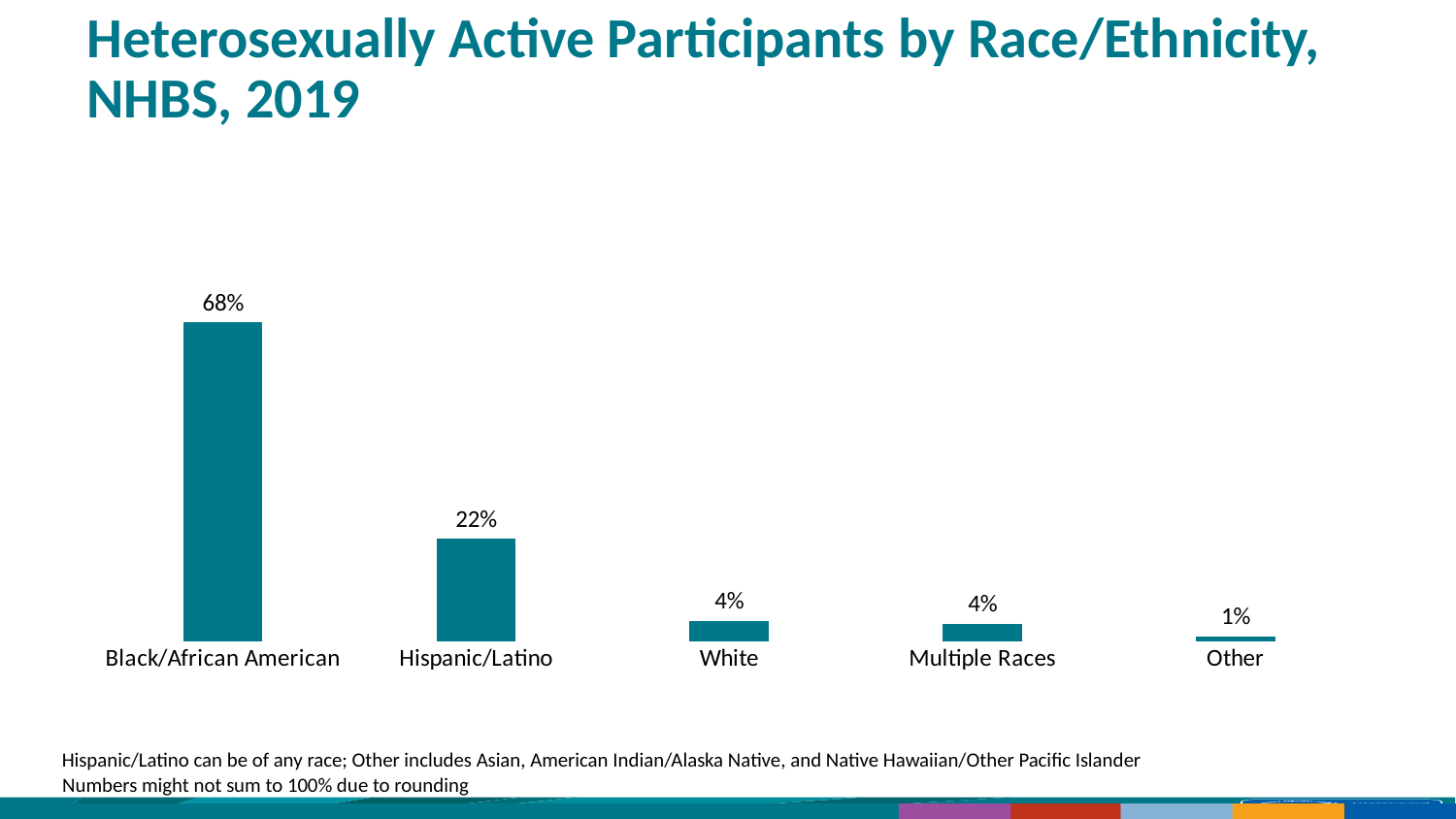
What is the difference in percentage points between Black/African American and Hispanic/Latino? 46 What is the value shown for Hispanic/Latino? 22% What is the title of the chart? Heterosexually Active Participants by Race/Ethnicity, NHBS, 2019 What percentage is shown for White participants? 4% Which is larger, the value for Hispanic/Latino or the value for White? Hispanic/Latino What is the value for the Other category? 1% Which race/ethnicity category has the highest percentage? Black/African American What percentage of heterosexually active participants were Black/African American? 68% What kind of chart is shown on the slide? Bar chart Which race/ethnicity category has the lowest percentage? Other How many race/ethnicity categories are shown in the chart? 5 Do the values rise or fall moving from left to right across the categories? Fall